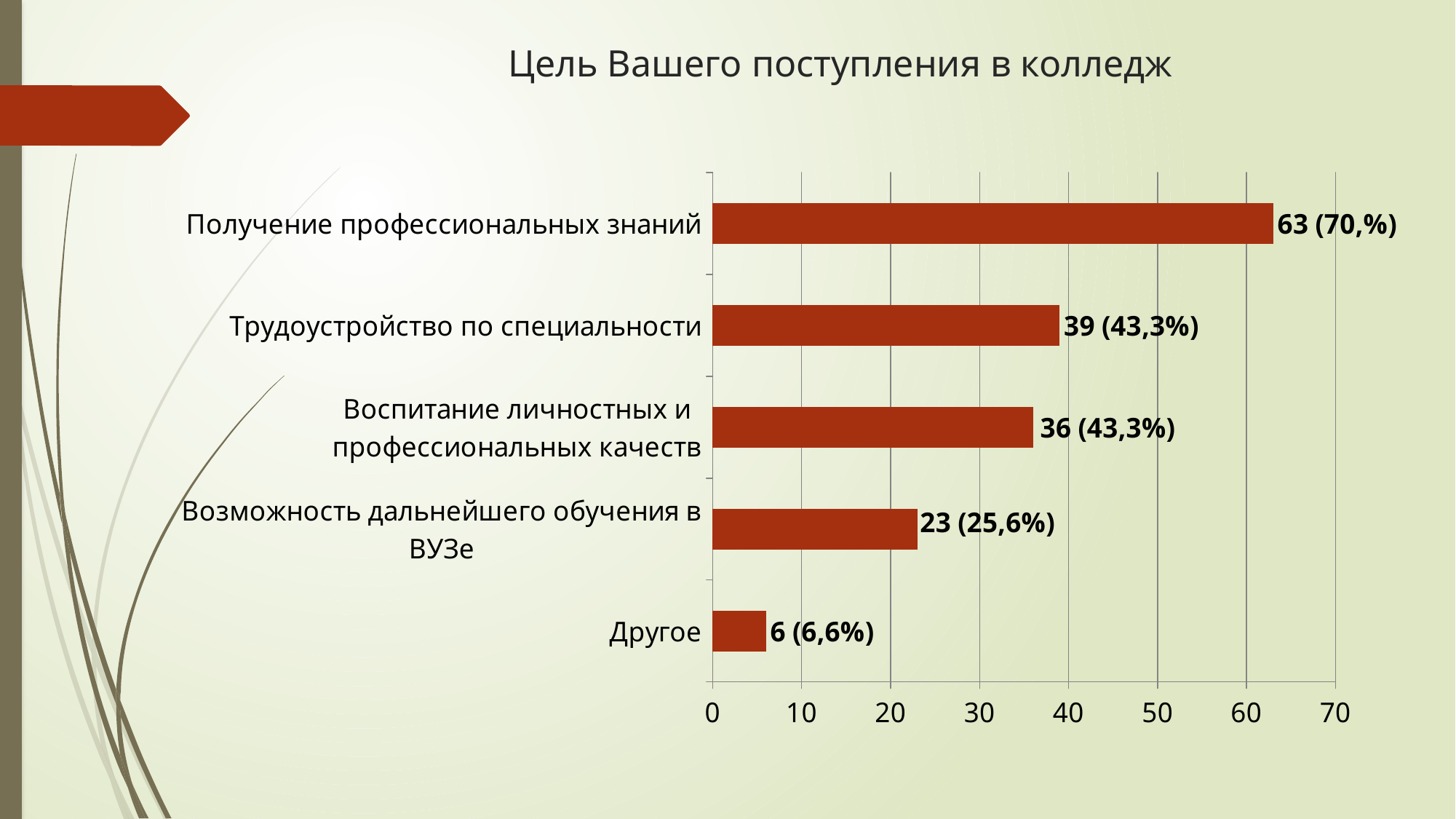
How many categories are plotted in the chart? 5 What is the data label for "Трудоустройство по специальности"? 39 (43,3%) What is the data label for "Получение профессиональных знаний"? 63 (70,%) Which category has the lowest value? Другое What kind of chart is shown on the slide? bar chart What is the difference between the counts for "Получение профессиональных знаний" and "Трудоустройство по специальности"? 24 What is the title of the chart? Цель Вашего поступления в колледж Which is larger: the value for "Трудоустройство по специальности" or for "Воспитание личностных и профессиональных качеств"? Трудоустройство по специальности Which category has the highest value? Получение профессиональных знаний What is the data label for "Другое"? 6 (6,6%) Is the value for "Воспитание личностных и профессиональных качеств" greater or less than 40? less What is the data label for "Возможность дальнейшего обучения в ВУЗе"? 23 (25,6%)